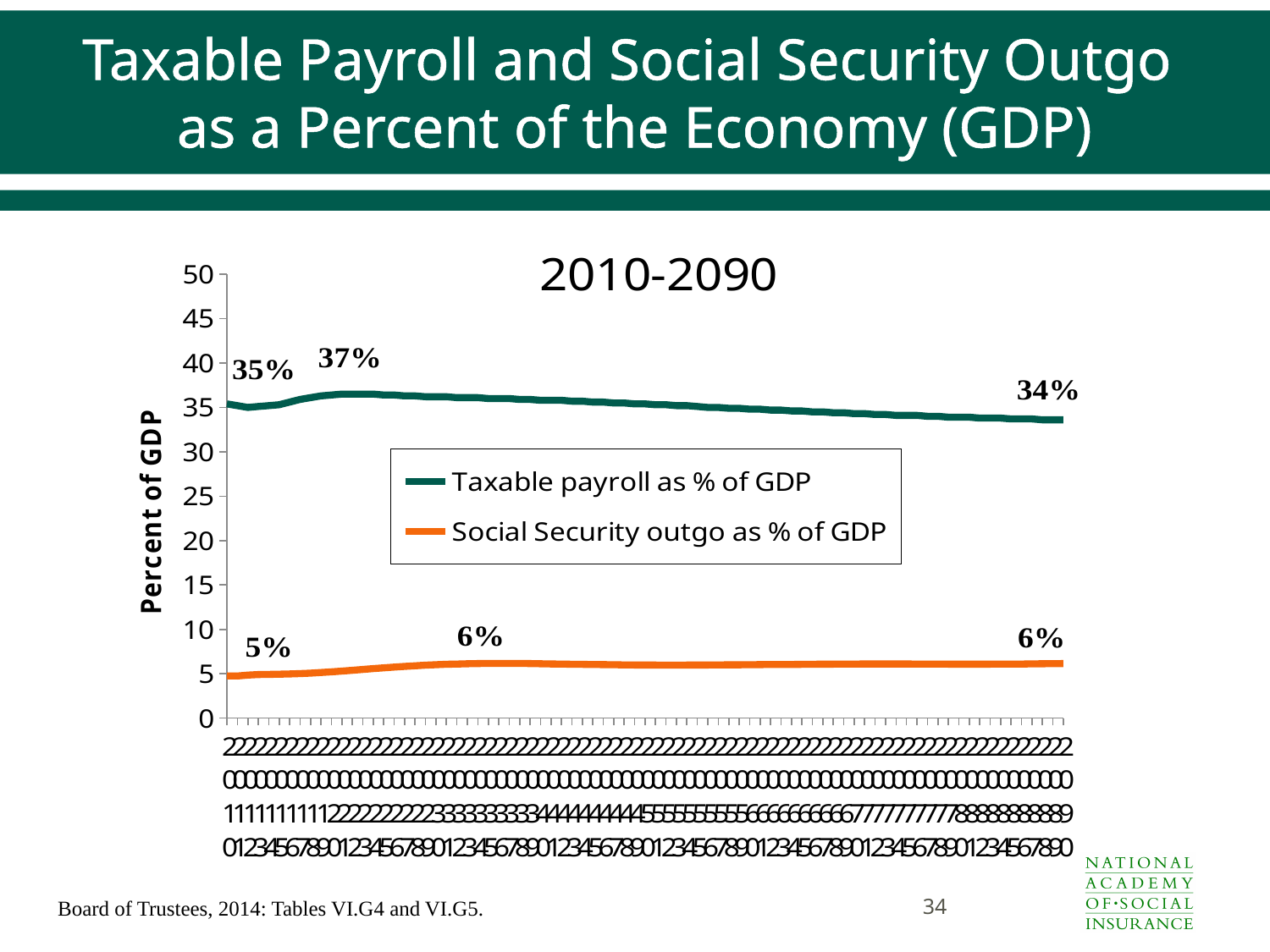
What is the label on the vertical axis of the chart? Percent of GDP How many series does the legend list? 2 What is the labelled value of Social Security outgo as % of GDP in 2090? 6% What is the labelled value of taxable payroll as % of GDP at the end of the series in 2090? 34% What is the labelled value of Social Security outgo as % of GDP in 2010? 5% What is the highest labelled value shown for taxable payroll as % of GDP? 37% What is the difference between the labelled taxable payroll value (34%) and the labelled Social Security outgo value (6%) in 2090? 28% What is the labelled value of taxable payroll as % of GDP at the start of the series in 2010? 35% Which series has the higher values throughout the chart, taxable payroll or Social Security outgo? Taxable payroll as % of GDP Is the value for taxable payroll as % of GDP in 2050 greater or less than 30? greater What kind of chart is shown on the slide? Line chart Is the value for Social Security outgo as % of GDP in 2050 greater or less than 10? less